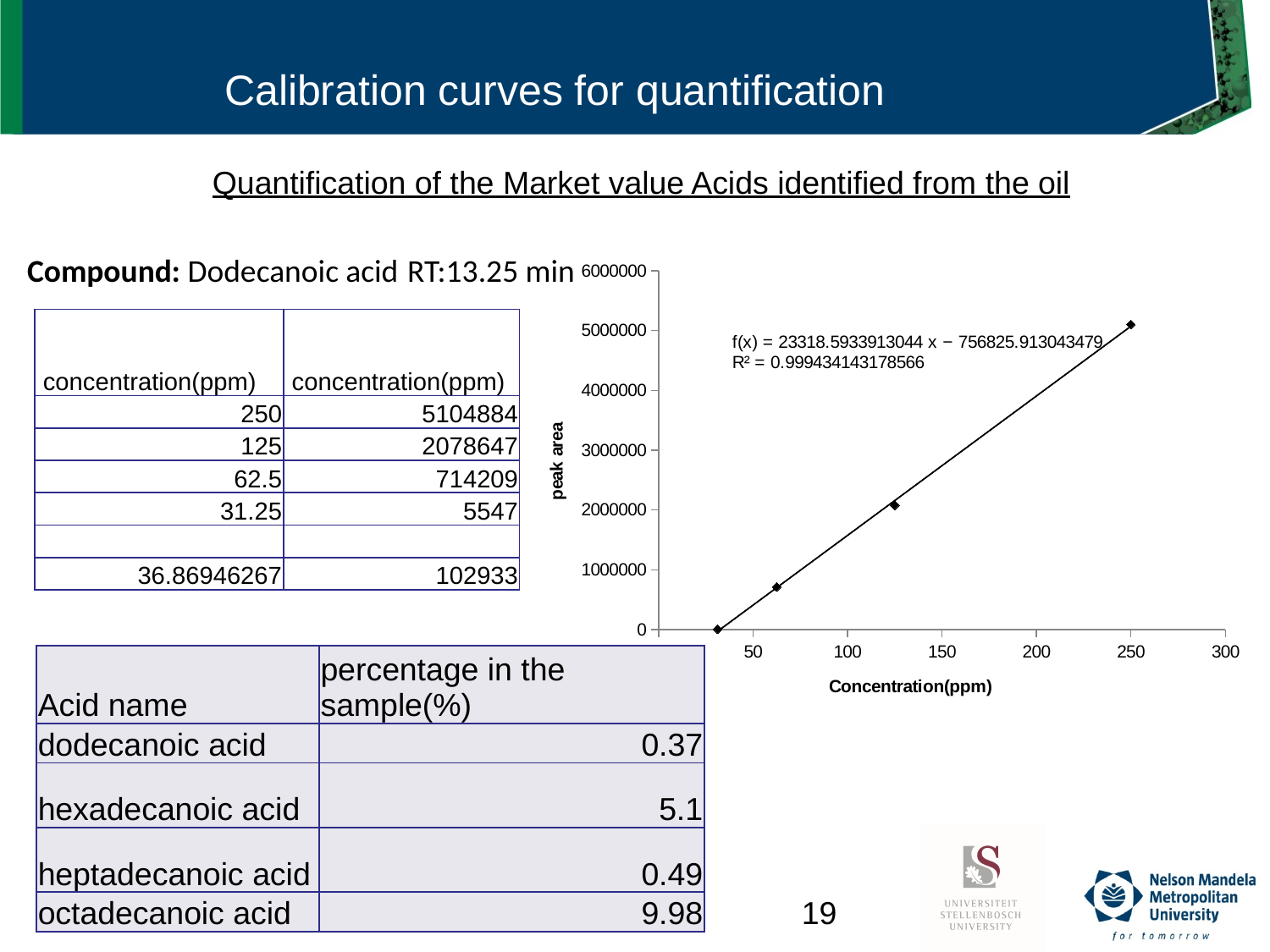
Does the peak area rise or fall as concentration increases along the x axis? rise Is the peak area at a concentration of 250 ppm greater or less than 4000000? greater Is the peak area at a concentration of 62.5 ppm greater or less than 1000000? less Is the peak area at a concentration of 125 ppm greater or less than 1000000? greater What kind of chart is shown on the slide? scatter chart What R² value is shown on the chart? 0.999434143178566 Which plotted concentration has the lowest peak area? 31.25 How many data points are plotted on the chart? 4 Which plotted concentration has the highest peak area? 250 What is the title of the x axis of the chart? Concentration(ppm) Which has the larger peak area: the point at 125 ppm or the point at 62.5 ppm? 125 ppm